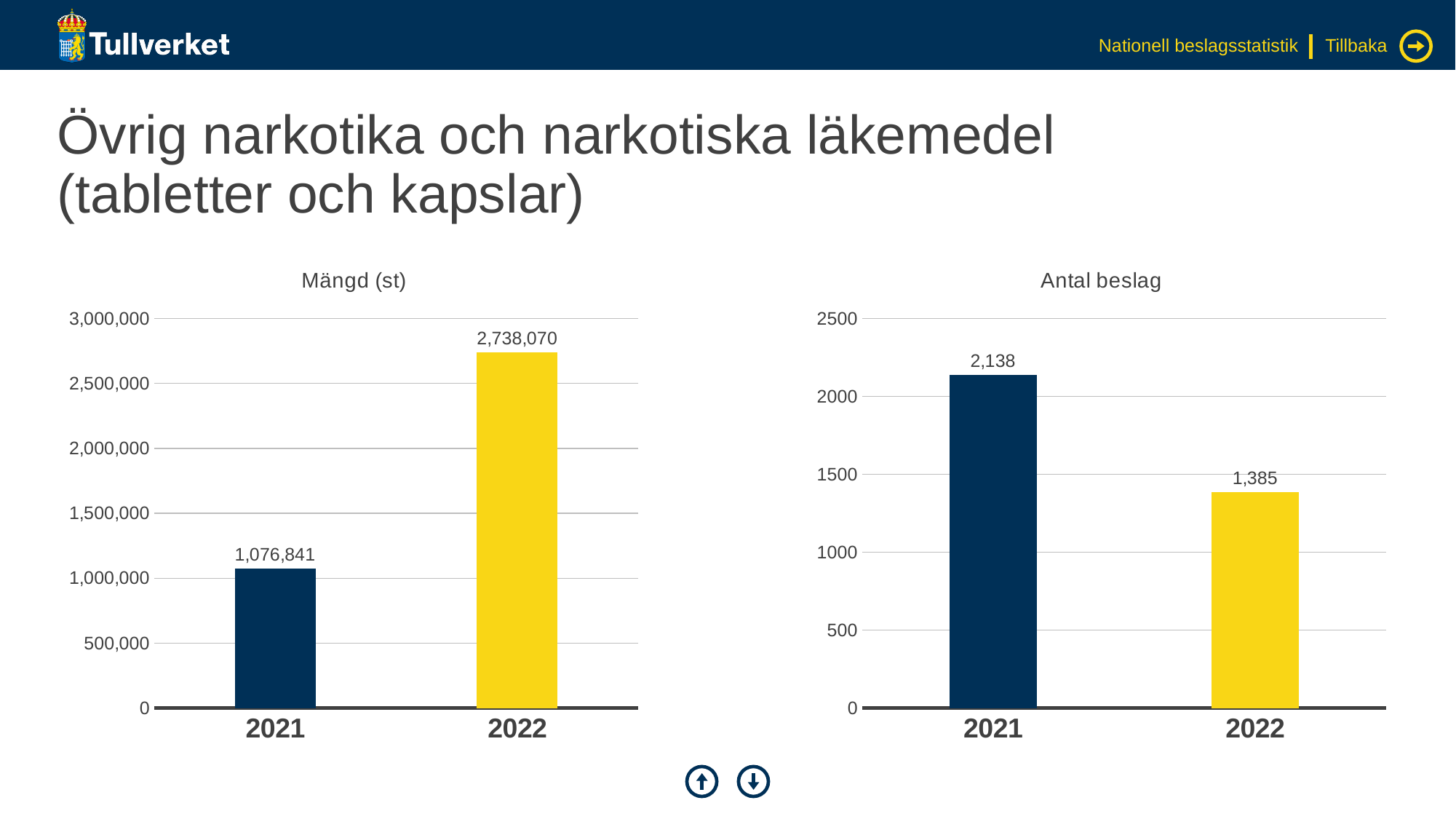
In the 'Antal beslag' chart, what is the value for 2021? 2,138 In the 'Antal beslag' chart, what is the value for 2022? 1,385 In the 'Mängd (st)' chart, what is the value for 2022? 2,738,070 In the 'Antal beslag' chart, is the value for 2021 greater or less than 2000? greater How many categories are shown on the x axis of the 'Mängd (st)' chart? 2 In the 'Mängd (st)' chart, do the values rise or fall from 2021 to 2022? rise In the 'Mängd (st)' chart, what is the difference between the 2022 and 2021 values? 1,661,229 What kind of chart is the 'Antal beslag' chart? bar chart In the 'Antal beslag' chart, which year has the lowest value? 2022 In the 'Mängd (st)' chart, what is the value for 2021? 1,076,841 In the 'Mängd (st)' chart, which year has the highest value? 2022 In the 'Antal beslag' chart, what is the difference between the 2021 and 2022 values? 753